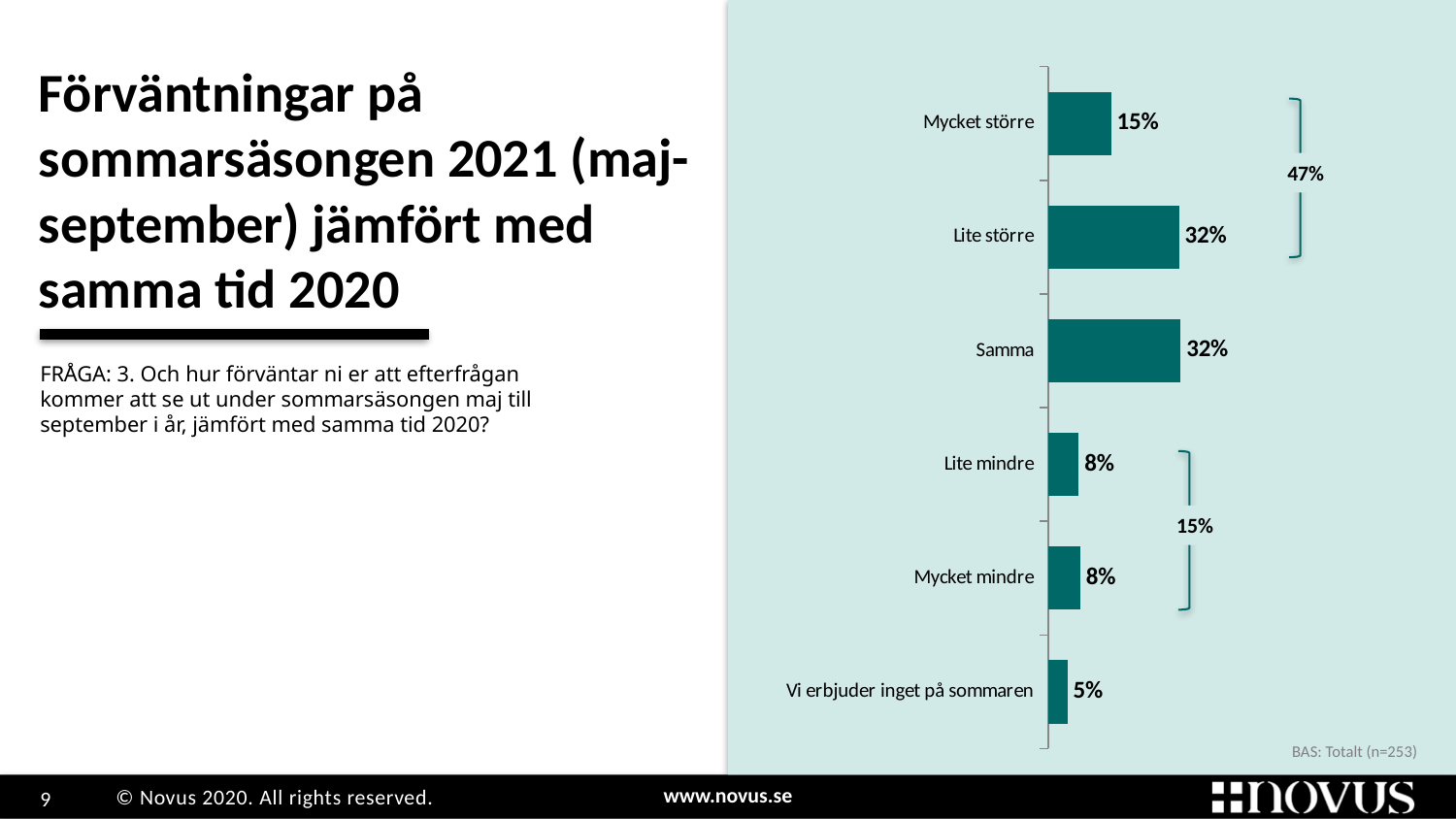
What is the value for "Mycket mindre"? 8% What is the value shown for "Lite större"? 32% How many categories are shown in the bar chart? 6 What is the difference in percentage points between "Lite större" and "Mycket större"? 17 percentage points What kind of chart is shown on the slide? Bar chart What is the value shown for "Samma"? 32% What is the sample size (n) stated in the base note below the chart? 253 What percentage is shown for "Vi erbjuder inget på sommaren"? 5% What combined percentage does the bracket next to "Mycket större" and "Lite större" show? 47% Which is larger, the value for "Mycket större" or the value for "Lite mindre"? Mycket större Which category has the lowest value in the chart? Vi erbjuder inget på sommaren What percentage of respondents answered "Mycket större"? 15%